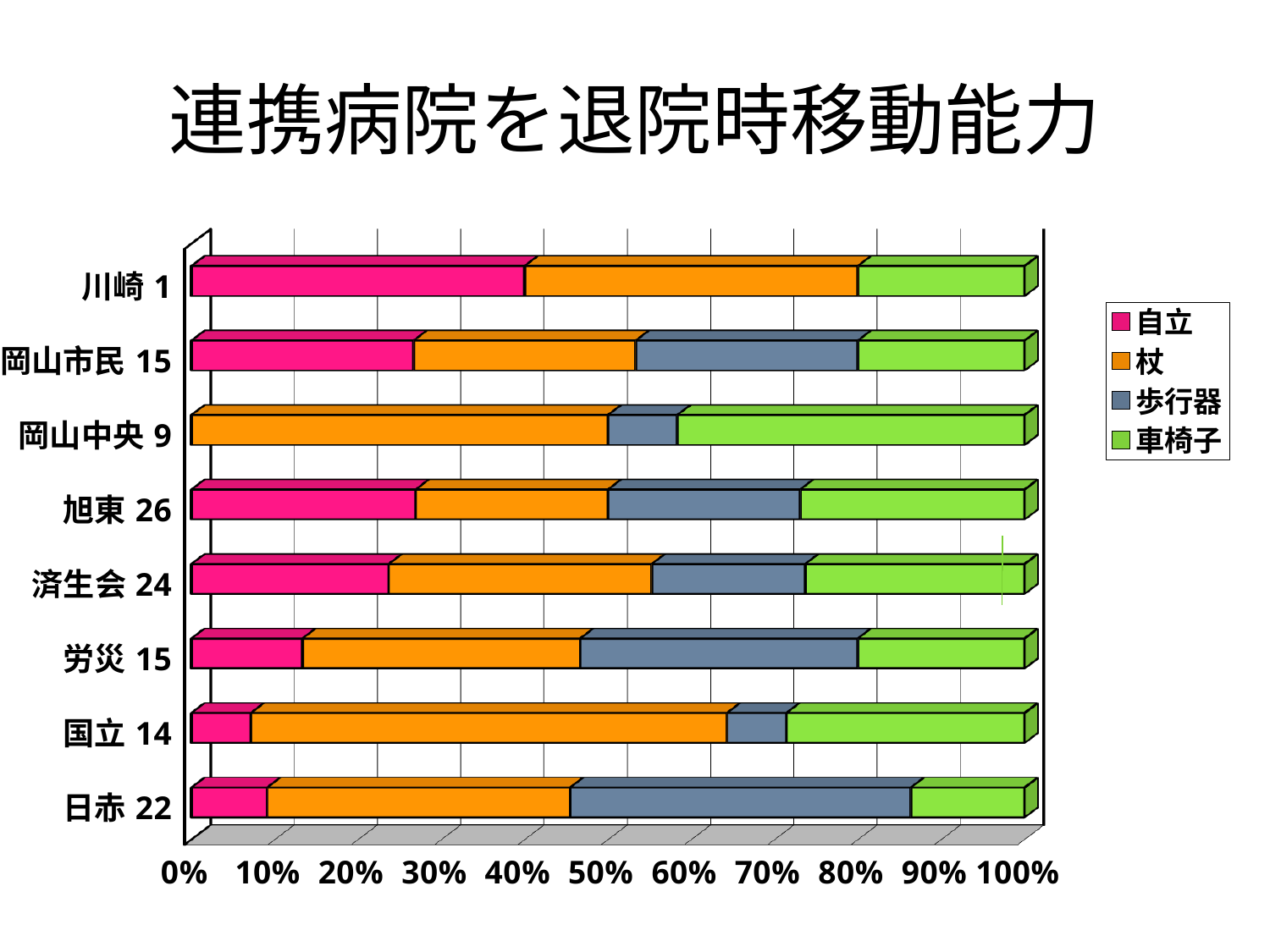
Is the 自立 share for 国立 14 greater or less than 10%? less What kind of chart is shown on the slide? Stacked bar chart Which hospital has the largest 車椅子 share? 岡山中央 9 Which has the larger 車椅子 share, 岡山中央 9 or 日赤 22? 岡山中央 9 Which hospital has the largest 自立 share? 川崎 1 What is the title of the chart? 連携病院を退院時移動能力 Which series is shown in pink/magenta in the legend? 自立 Which hospital has the largest 歩行器 share? 日赤 22 How many series does the legend list? 4 Is the 自立 share for 川崎 1 greater or less than 30%? greater Which hospital has no 自立 segment at all? 岡山中央 9 How many hospitals (categories) are plotted on the chart? 8